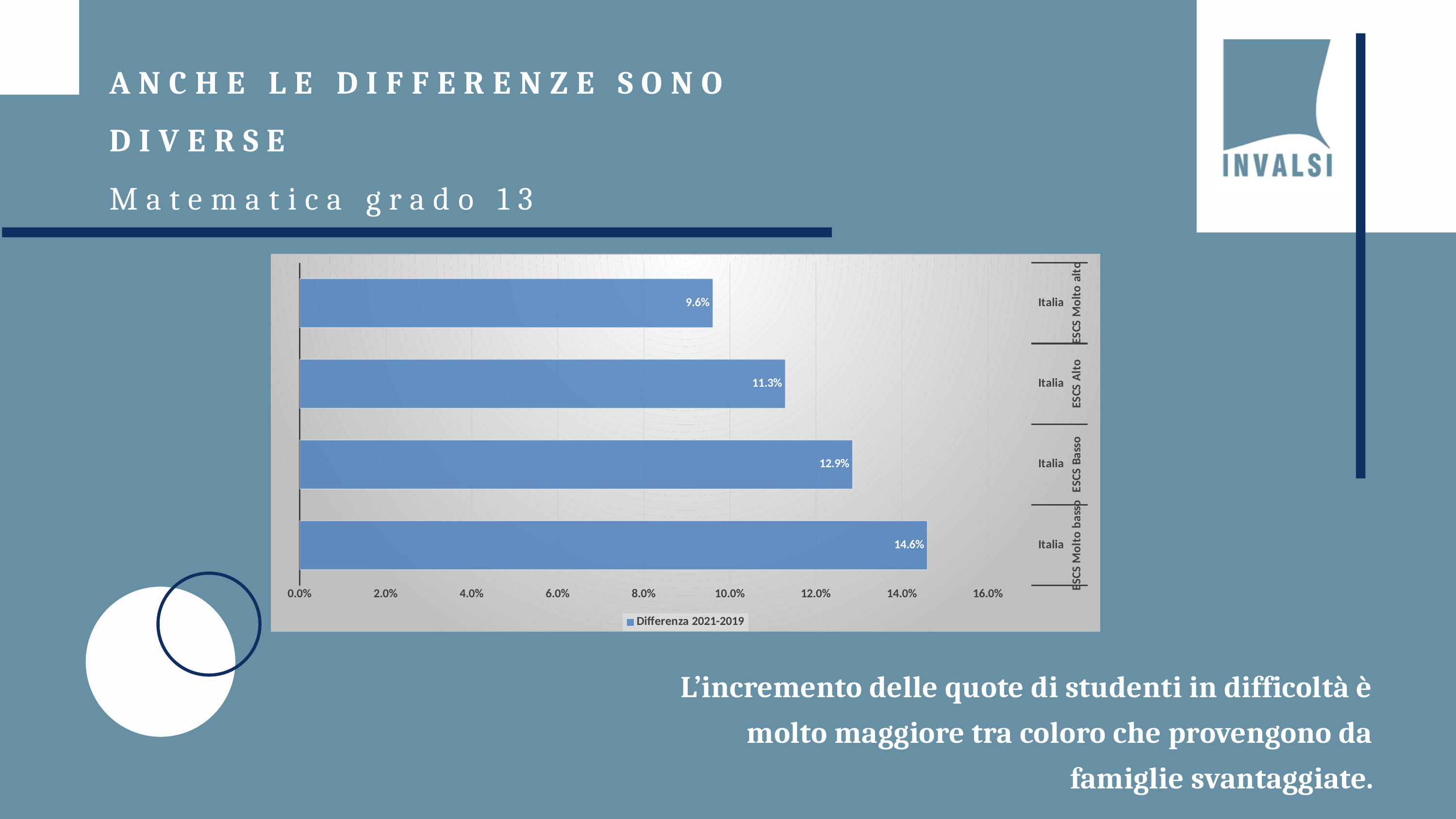
What is the difference between the values for ESCS Molto basso and ESCS Molto alto? 5.0% What series name does the legend show? Differenza 2021-2019 What kind of chart is shown on the slide? bar chart What is the value for ESCS Basso? 12.9% Which category has the highest value? ESCS Molto basso What is the value for ESCS Molto alto? 9.6% What is the value for ESCS Alto? 11.3% Which category has the lowest value? ESCS Molto alto How many categories are shown in the chart? 4 What is the value for ESCS Molto basso? 14.6% Is the value for ESCS Alto greater or less than 12.0%? less Which is larger, the value for ESCS Alto or the value for ESCS Basso? ESCS Basso